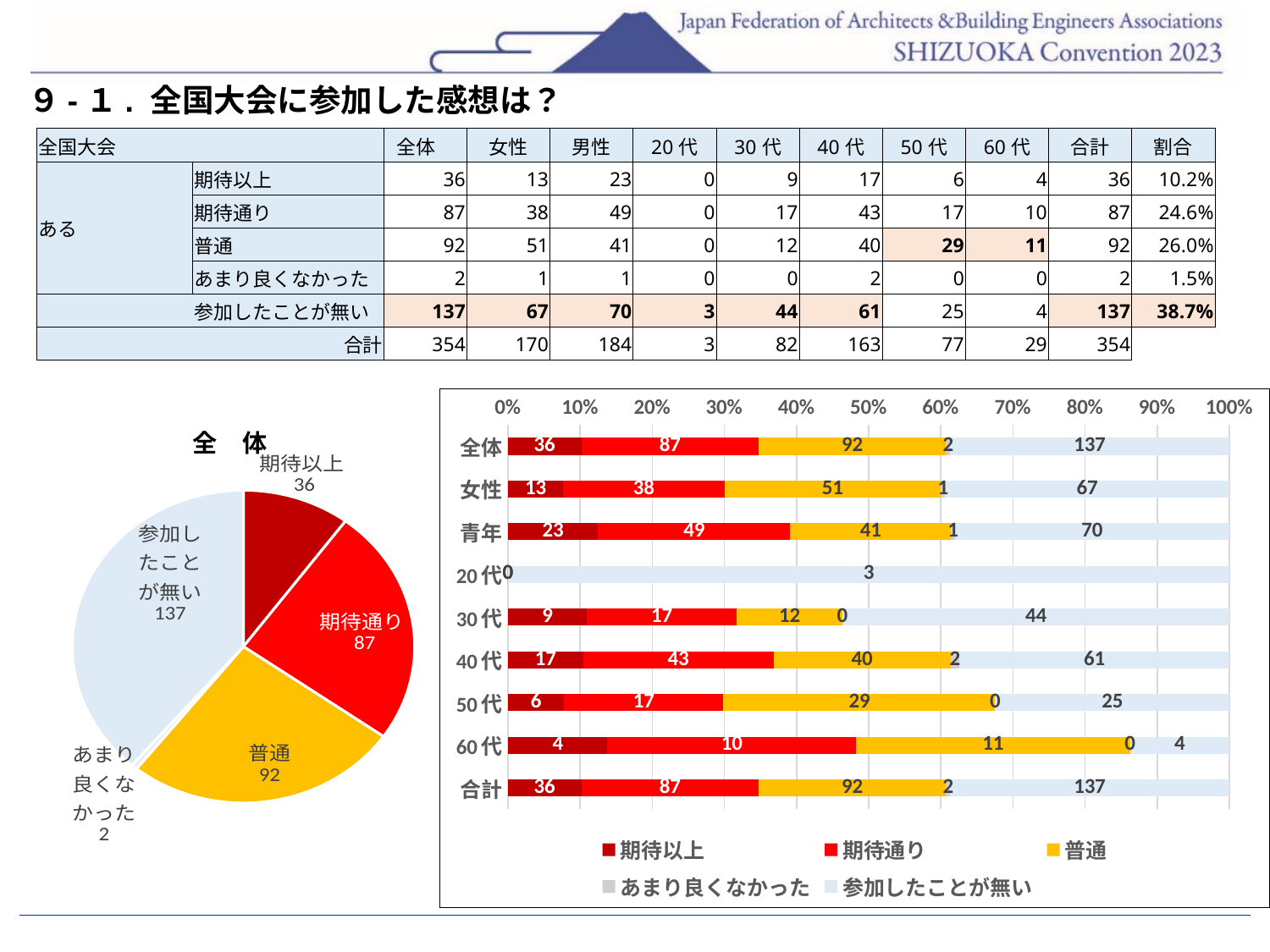
What kind of chart is the chart on the right of the slide? bar chart In the pie chart titled 全 体, what is the value for 期待通り? 87 In the bar chart on the right, how many series does the legend list? 5 In the pie chart titled 全 体, how many slices are there? 5 In the bar chart on the right, what is the value of 参加したことが無い for 30代? 44 In the bar chart on the right, which is larger for 女性: 期待通り or 普通? 普通 In the pie chart titled 全 体, which slice is the smallest? あまり良くなかった In the bar chart on the right, what is the value of 期待通り for 40代? 43 What kind of chart is the chart on the left titled 全 体? pie chart In the pie chart titled 全 体, which slice is the largest? 参加したことが無い In the bar chart on the right, how many categories are shown on the vertical axis? 9 In the pie chart titled 全 体, what is the difference between 普通 and 期待通り? 5